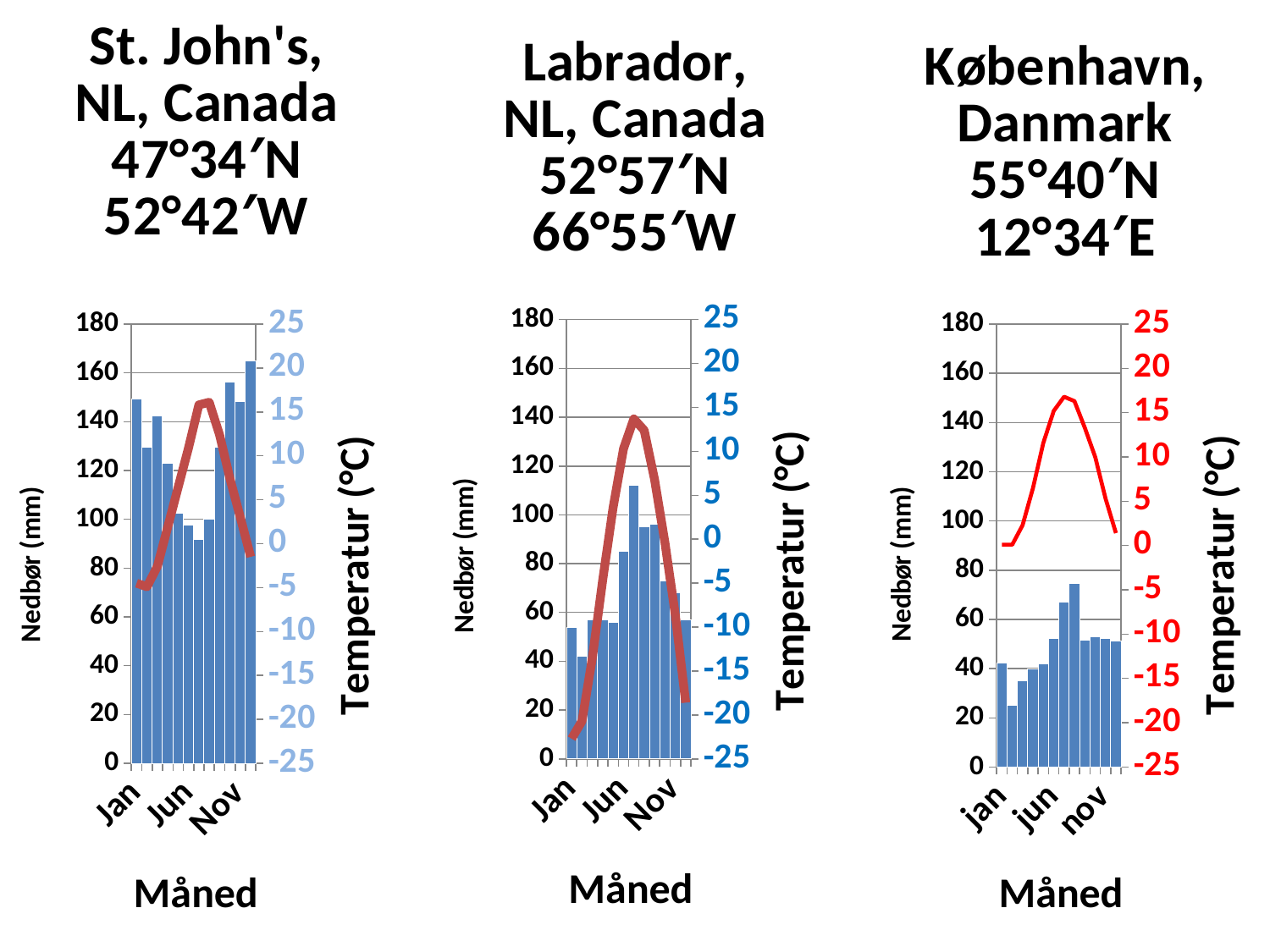
What is the label on the left-hand vertical axis of the Labrador, NL, Canada chart? Nedbør (mm) How many bars (months) are plotted in the Labrador, NL, Canada chart? 12 In the København, Danmark chart, is the tallest precipitation bar greater or less than 60? greater What is the label on the right-hand vertical axis of the København, Danmark chart? Temperatur (°C) In the København, Danmark chart, is the precipitation bar for the second month (Feb) greater or less than 40? less In the Labrador, NL, Canada chart, is the tallest precipitation bar greater or less than 100? greater What kind of chart is the St. John's, NL, Canada chart? A combined bar and line chart In the St. John's, NL, Canada chart, does the temperature line rise or fall from Jan to its peak in late summer? rise In the Labrador, NL, Canada chart, which precipitation bar is taller: Jan or the tallest summer bar (Jul)? Jul